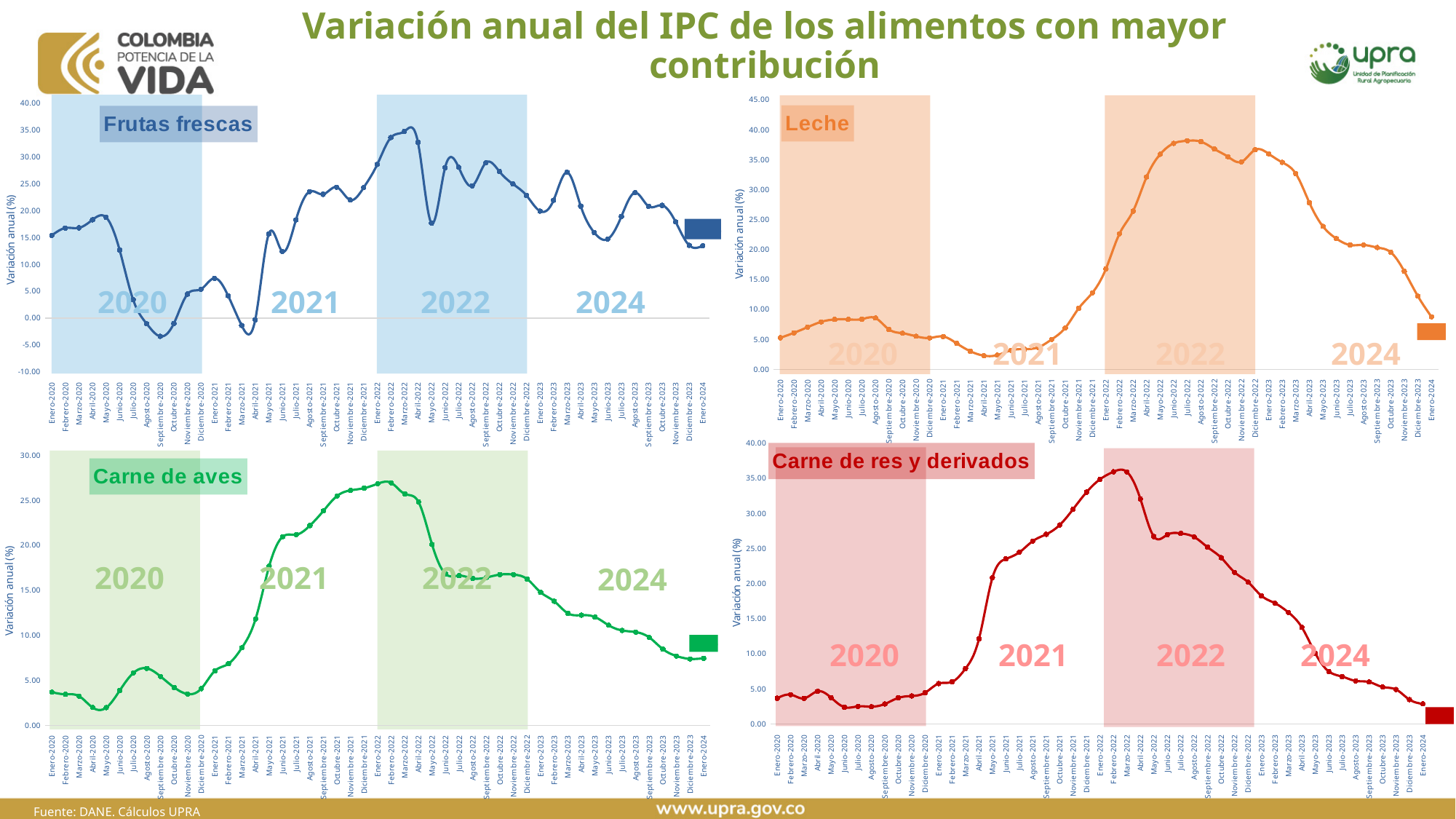
In the 'Frutas frescas' chart, which is larger, the value for Enero-2020 or the value for Septiembre-2020? Enero-2020 In the 'Frutas frescas' chart, is the value for Septiembre-2020 greater or less than 0.00? less How many charts are shown on the slide? 4 What is the title of the slide's charts? Variación anual del IPC de los alimentos con mayor contribución In the 'Frutas frescas' chart, is the value for Enero-2020 greater or less than 10.00? greater In the 'Leche' chart, do the values rise or fall from Julio-2022 to Enero-2024? fall In the 'Carne de res y derivados' chart, is the value for Enero-2024 greater or less than 5.00? less In the 'Carne de aves' chart, do the values rise or fall from Enero-2021 to Enero-2022? rise What kind of chart is used for the 'Frutas frescas' panel? line chart